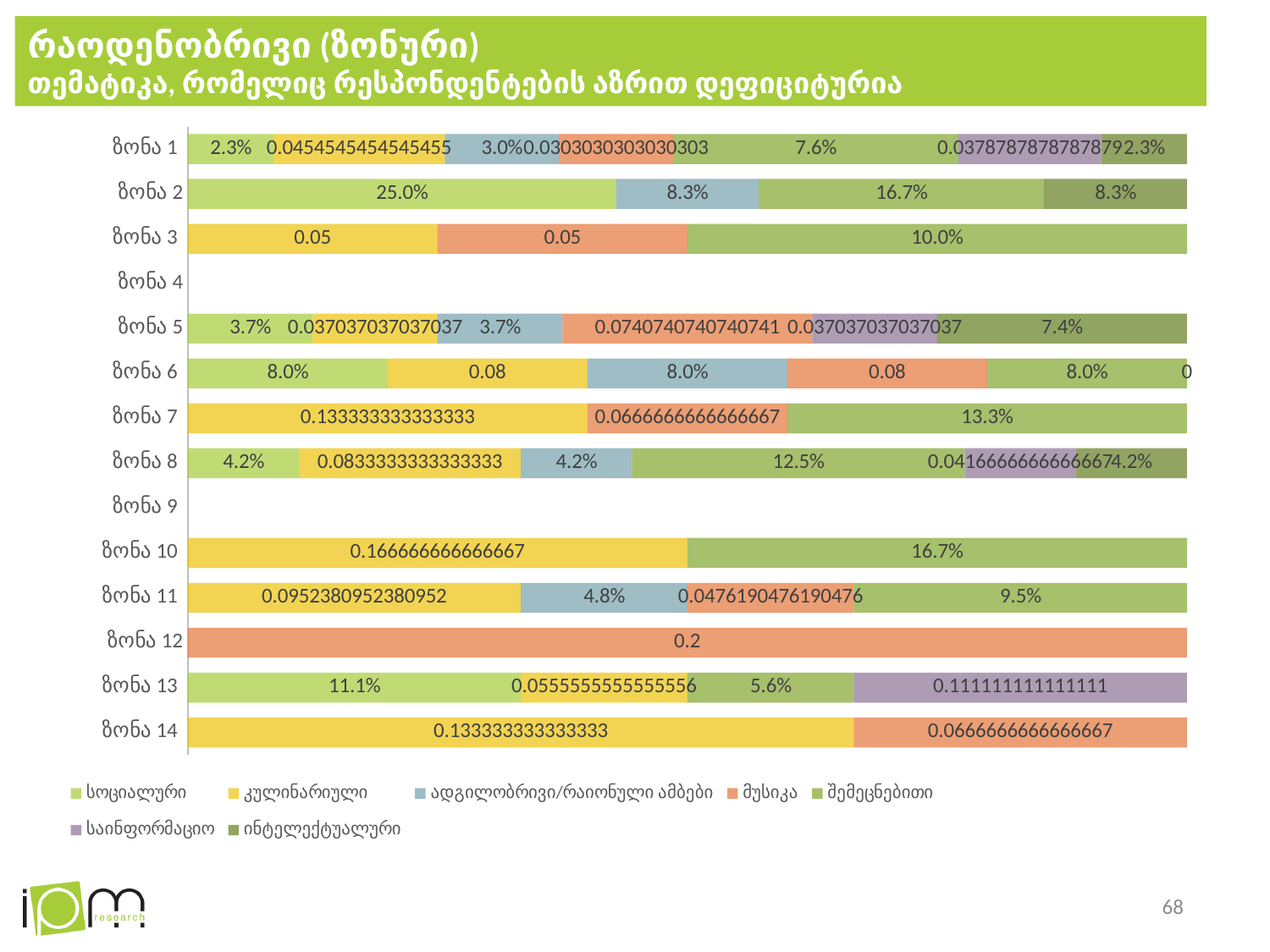
What is the value of სოციალური for ზონა 2? 25.0% What is the value of შემეცნებითი for ზონა 3? 10.0% What is the value of ადგილობრივი/რაიონული ამბები for ზონა 11? 4.8% How many zone categories (ზონა) are listed on the vertical axis? 14 What is the value of მუსიკა for ზონა 12? 0.2 What kind of chart is shown on the slide? stacked bar chart How many series does the legend list? 7 For ზონა 2, what is the difference between სოციალური (25.0%) and შემეცნებითი (16.7%)? 8.3% Which zones have no bars plotted at all? ზონა 4 and ზონა 9 For ზონა 2, which is larger: სოციალური or შემეცნებითი? სოციალური What is the value of სოციალური for ზონა 13? 11.1% What is the value of შემეცნებითი for ზონა 10? 16.7%